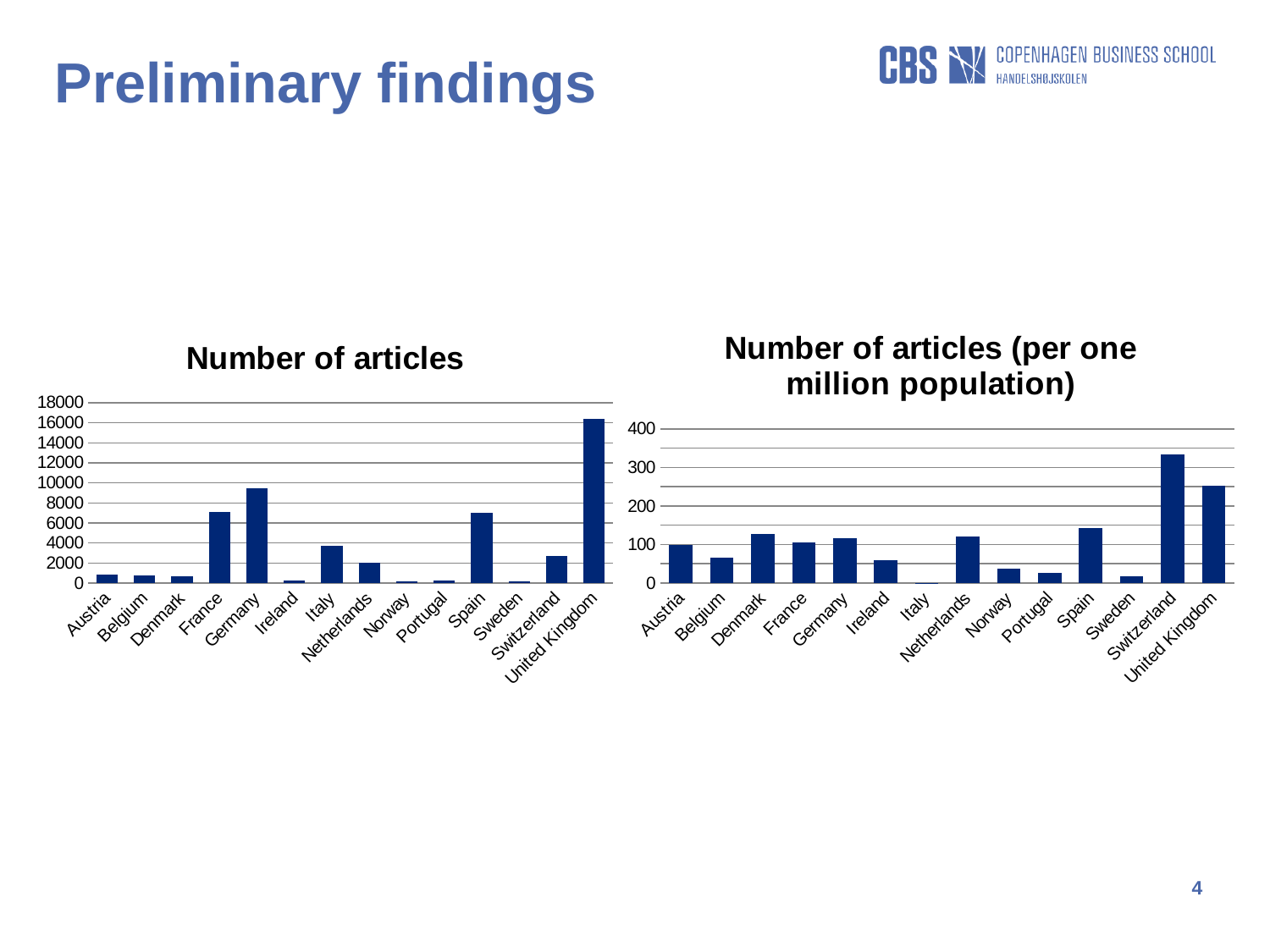
In the 'Number of articles' chart, which country has the highest value? United Kingdom In the 'Number of articles' chart, which is larger, the value for Germany or the value for Italy? Germany What type of chart is the 'Number of articles (per one million population)' chart? Bar chart In the 'Number of articles' chart, is the value for United Kingdom greater or less than 14000? greater In the 'Number of articles' chart, is the value for Netherlands greater or less than 4000? less In the 'Number of articles (per one million population)' chart, which is larger, the value for United Kingdom or the value for Spain? United Kingdom In the 'Number of articles' chart, is the value for Germany greater or less than 8000? greater How many countries are shown in the 'Number of articles' chart? 14 In the 'Number of articles (per one million population)' chart, which country has the lowest value? Italy In the 'Number of articles (per one million population)' chart, which country has the highest value? Switzerland